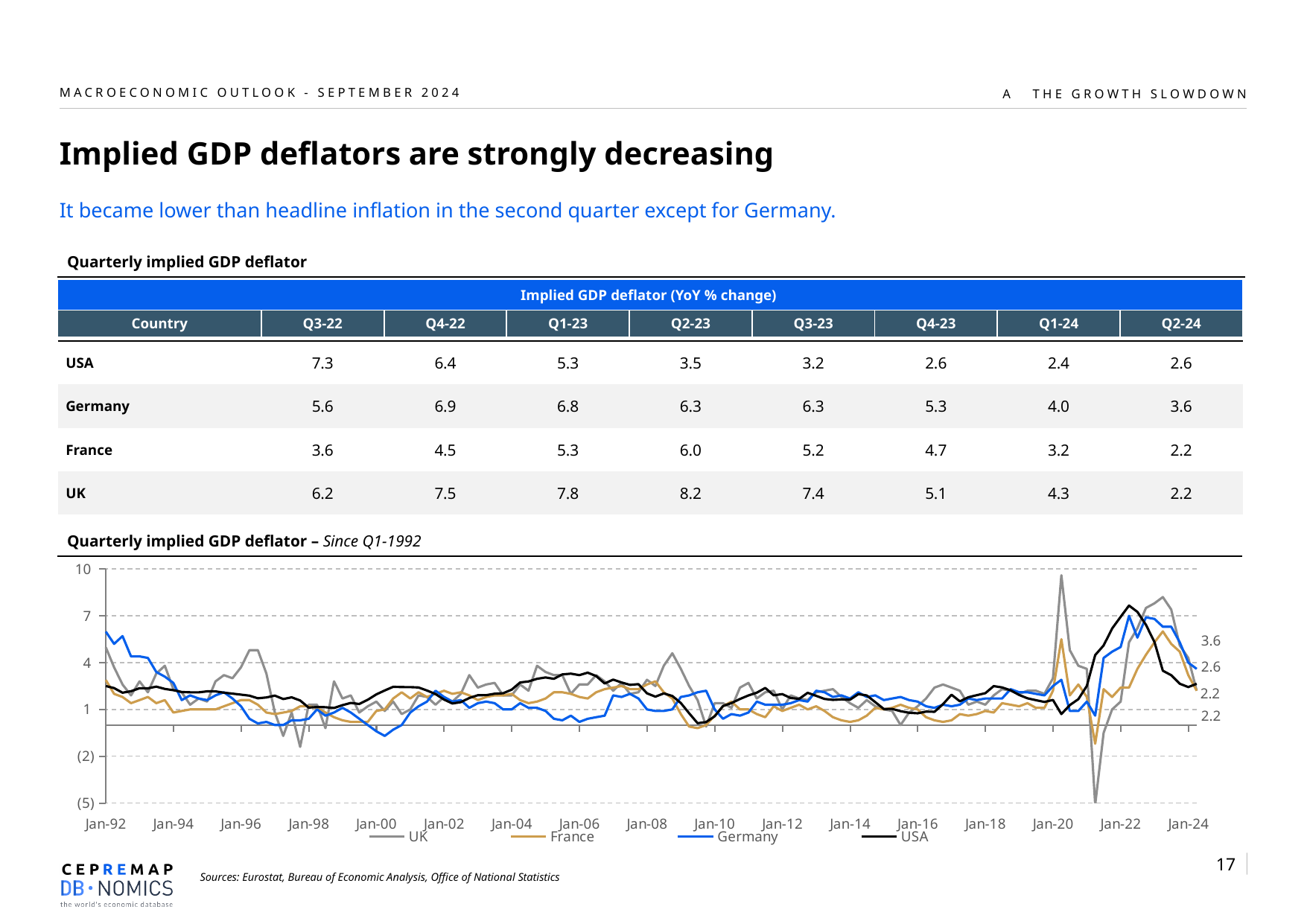
What kind of chart is shown under the heading 'Quarterly implied GDP deflator – Since Q1-1992'? line chart Which countries are listed in the legend of the line chart? UK, France, Germany, USA In the line chart, is the peak of the UK line around Jan-20 greater or less than 7? greater How many series does the legend of the line chart list? 4 In the line chart, what is the difference between the latest labelled values for Germany and the USA? 1.0 In the line chart, what is the latest value labelled at the end of the Germany line? 3.6 In the line chart, is the latest labelled value for Germany larger or smaller than the latest labelled value for France? larger In the line chart, is the lowest point of the UK line around 2020 greater or less than (2)? less In the line chart, what is the latest value labelled at the end of the USA line? 2.6 In the line chart, what is the latest value labelled at the end of the France line? 2.2 In the line chart, do the values for the USA rise or fall between Jan-22 and Jan-24? fall In the line chart, which country has the highest value at the end of the series (latest labelled point)? Germany